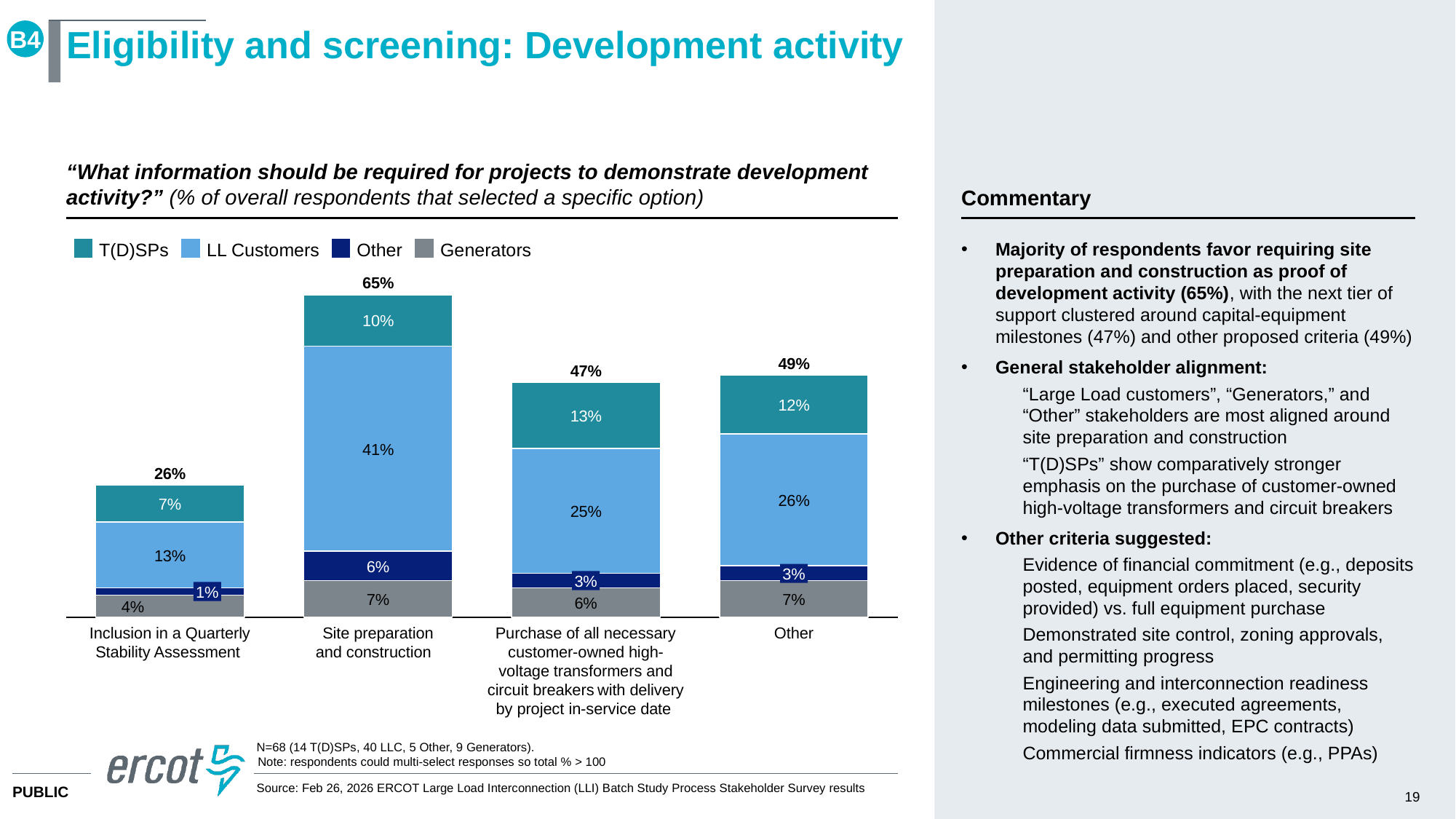
What type of chart is shown on the slide? Stacked bar chart Which category has the highest total? Site preparation and construction How many categories are shown on the x axis? 4 What is the difference between the total for Site preparation and construction and the total for Purchase of all necessary customer-owned high-voltage transformers and circuit breakers? 18 percentage points How many series does the legend list? 4 What is the Generators value for Inclusion in a Quarterly Stability Assessment? 4% What is the T(D)SPs value for Purchase of all necessary customer-owned high-voltage transformers and circuit breakers with delivery by project in-service date? 13% Which is larger: the LL Customers value for Other or the LL Customers value for Inclusion in a Quarterly Stability Assessment? Other Which category has the lowest total? Inclusion in a Quarterly Stability Assessment What is the total shown above the bar for the Other category? 49% What is the Other series value for the Other category? 3% What is the LL Customers value for Site preparation and construction? 41%